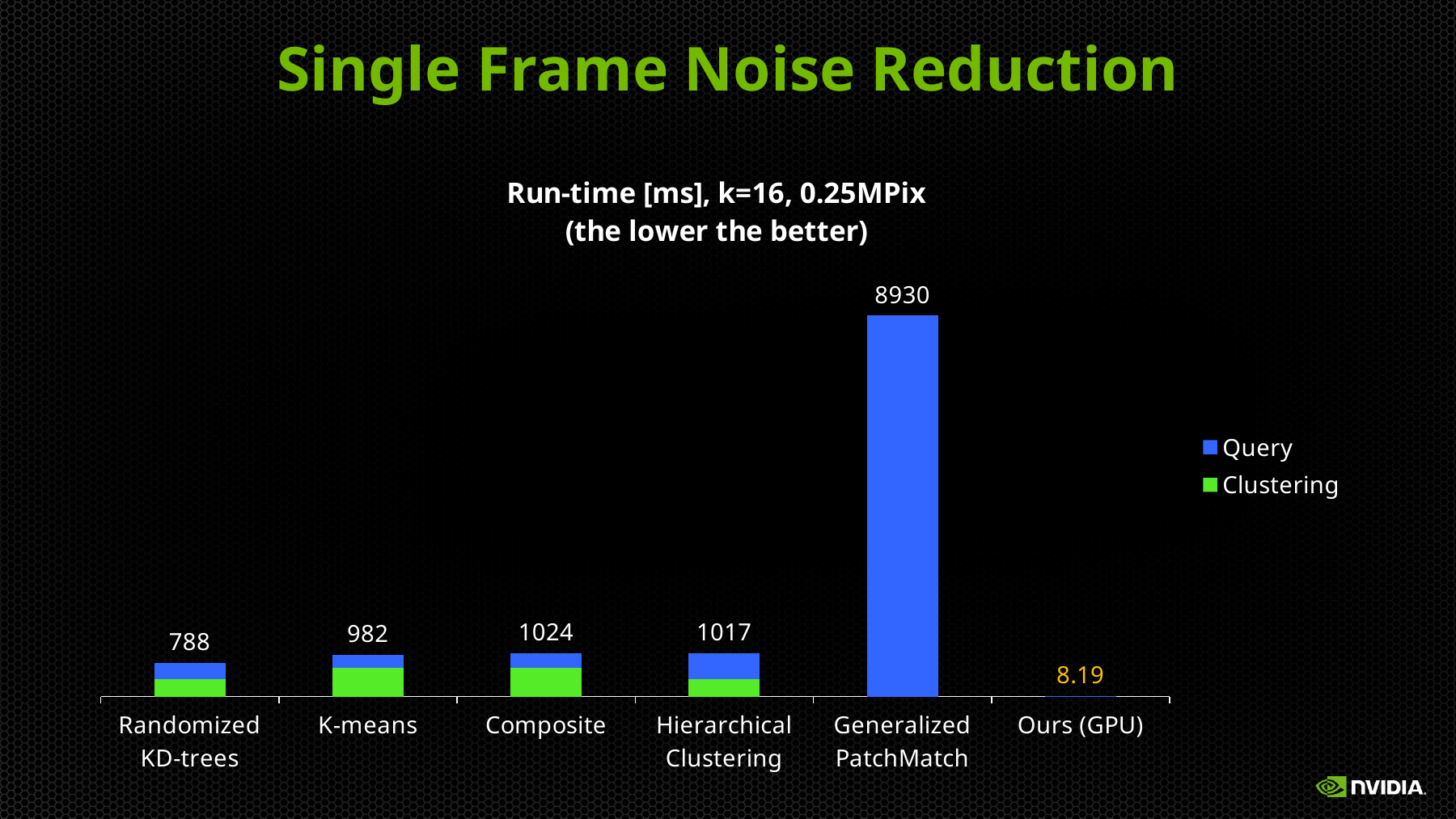
What is the total run-time shown for Generalized PatchMatch? 8930 What is the run-time shown for Ours (GPU)? 8.19 What is the total run-time shown for Composite? 1024 How many methods are compared on the x axis? 6 Which method has the highest total run-time? Generalized PatchMatch Which method has the lowest run-time? Ours (GPU) What is the difference between the total run-time of K-means and Randomized KD-trees? 194 What is the difference between the total run-time of Generalized PatchMatch and Randomized KD-trees? 8142 What is the total run-time shown for Randomized KD-trees? 788 What kind of chart is shown on the slide? Stacked bar chart Which has a larger total run-time, Composite or Hierarchical Clustering? Composite How many series does the legend list? 2